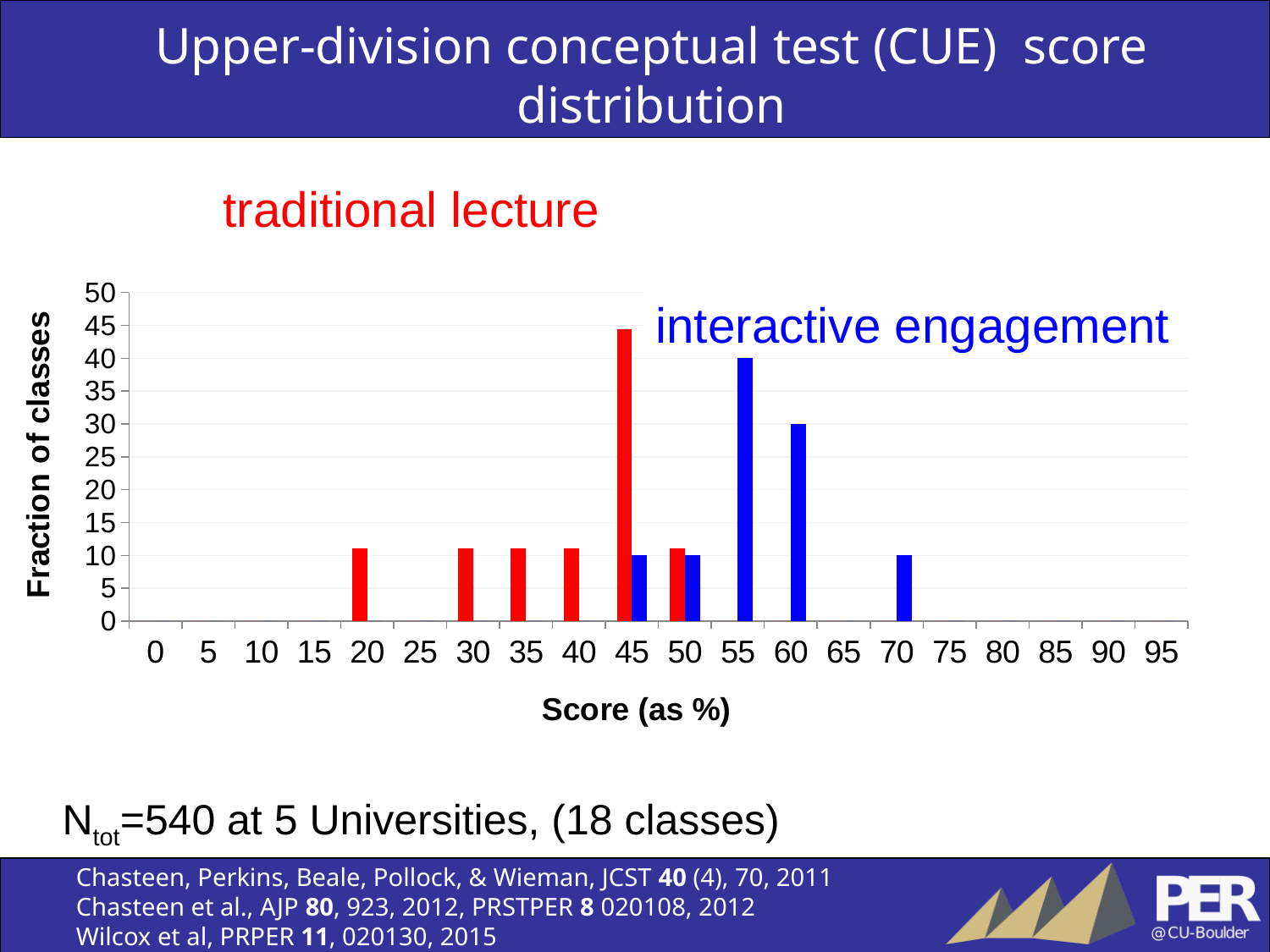
What is the label on the vertical axis of the chart? Fraction of classes At a score of 45, which series has the higher fraction of classes, traditional lecture or interactive engagement? traditional lecture How many bars are plotted for the traditional lecture series? 6 At which score does the interactive engagement series reach its highest fraction of classes? 55 What is the fraction of classes for interactive engagement at a score of 60? 30 What kind of chart is shown on the slide? bar chart How many series are plotted in the chart? 2 Is the traditional lecture value at a score of 45 greater or less than 40? greater At which score does the traditional lecture series reach its highest fraction of classes? 45 Is the traditional lecture value at a score of 20 greater or less than 15? less What is the fraction of classes for interactive engagement at a score of 55? 40 How many bars are plotted for the interactive engagement series? 5